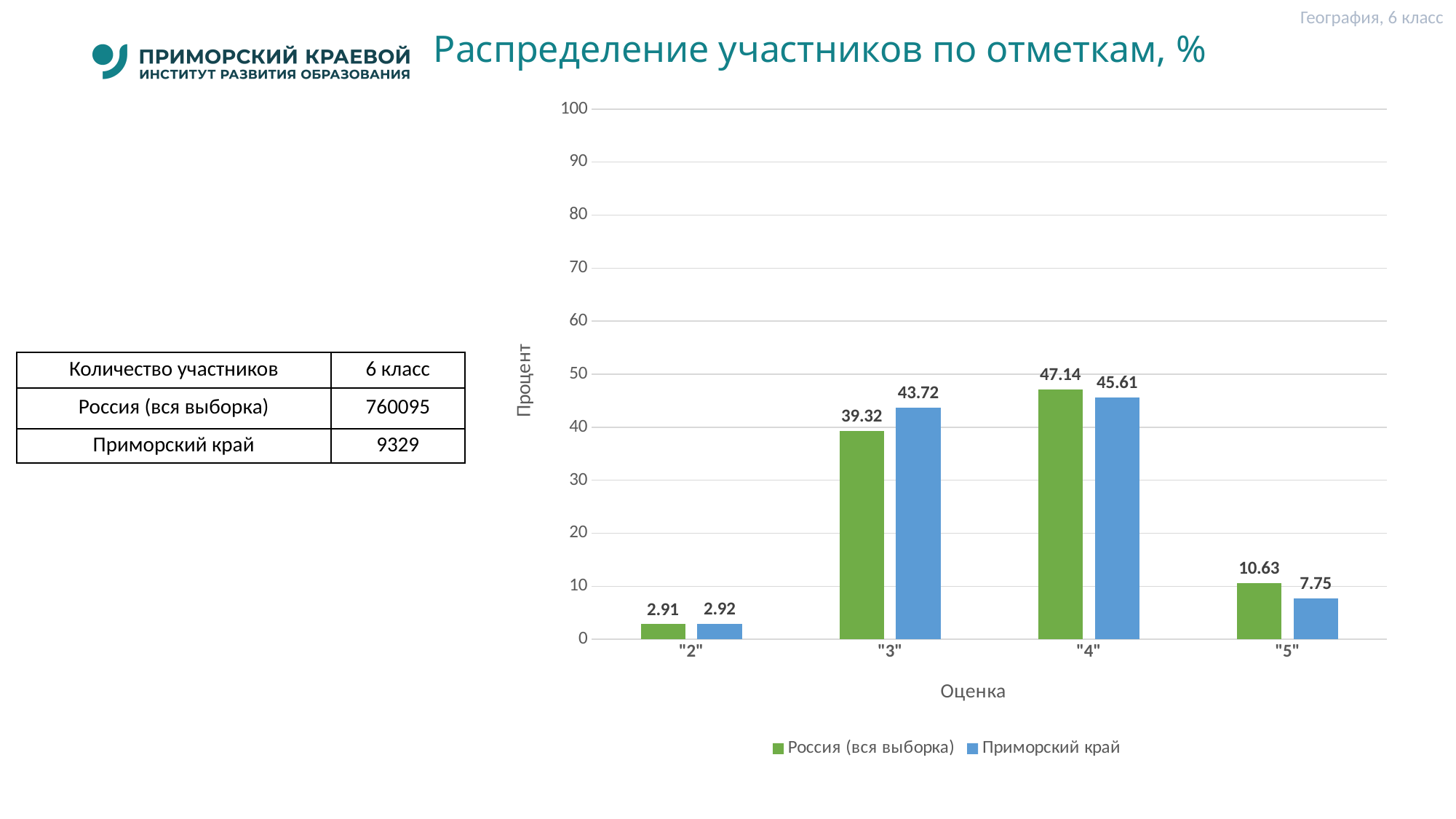
How many series does the legend list? 2 Which is larger at grade "3": Россия (вся выборка) or Приморский край? Приморский край What is the value for Приморский край at grade "5"? 7.75 What kind of chart is shown on the slide? Bar chart Which grade has the lowest value for Приморский край? "2" What is the difference between Россия (вся выборка) and Приморский край at grade "5"? 2.88 What is the value for Россия (вся выборка) at grade "3"? 39.32 Which grade has the highest value for Россия (вся выборка)? "4" What is the title of the chart? Распределение участников по отметкам, % What is the value for Приморский край at grade "4"? 45.61 How many grade categories are shown on the x axis? 4 What is the difference between Приморский край and Россия (вся выборка) at grade "3"? 4.40